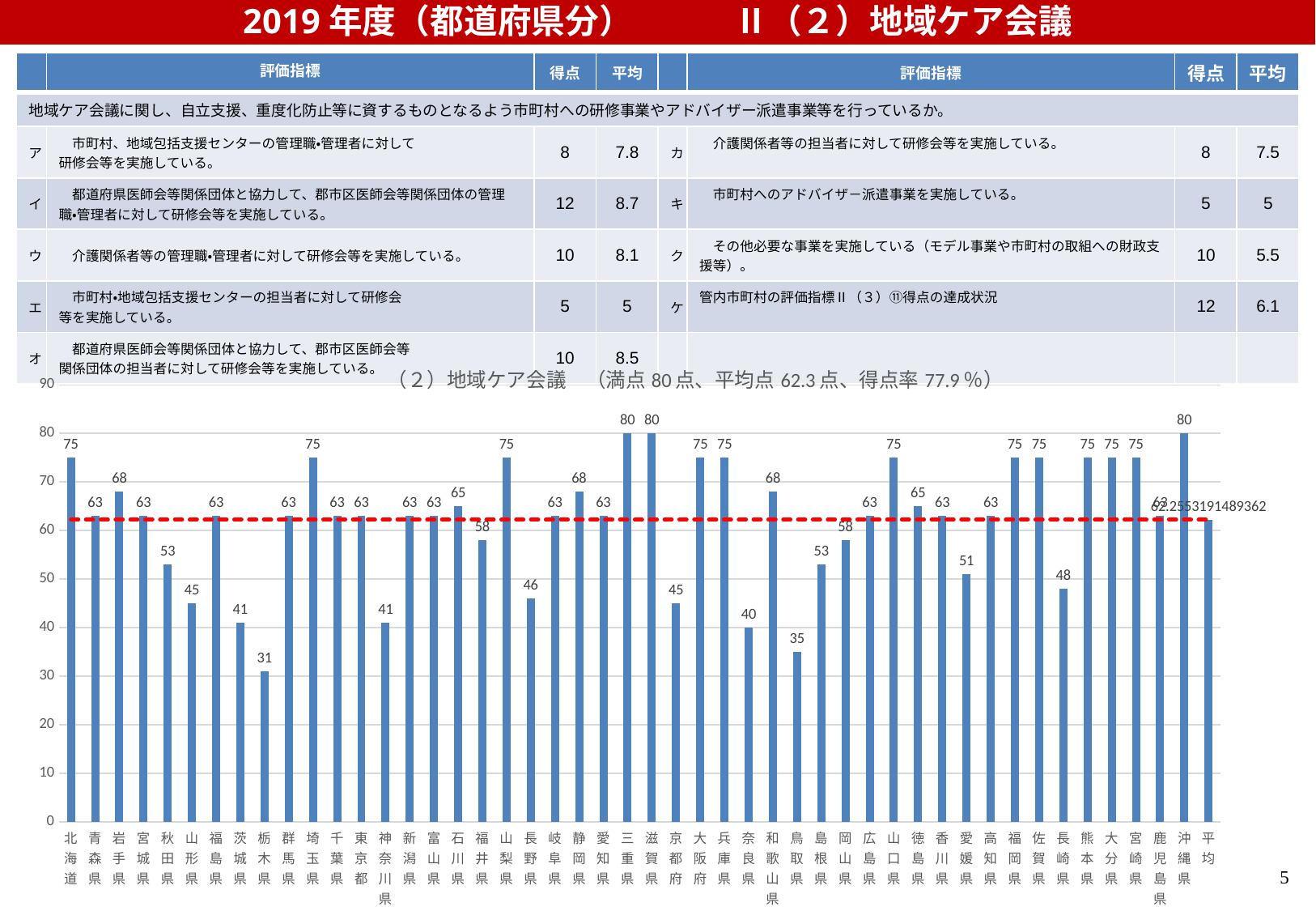
How many bars are plotted in the chart, including 平均? 48 Is the value for 鳥取県 greater or less than 40? less What is the difference between the values for 北海道 and 栃木県? 44 Which has the larger value, 静岡県 or 愛知県? 静岡県 Which has the larger value, 秋田県 or 山形県? 秋田県 What value is labelled on the red dashed line in the chart? 62.2553191489362 What is the value for 沖縄県 in the bar chart? 80 Which prefecture has the lowest value in the bar chart? 栃木県 What is the difference between the values for 岩手県 and 青森県? 5 What kind of chart is shown on the slide? bar chart What is the value for 奈良県 in the bar chart? 40 What is the value for 栃木県 in the bar chart? 31